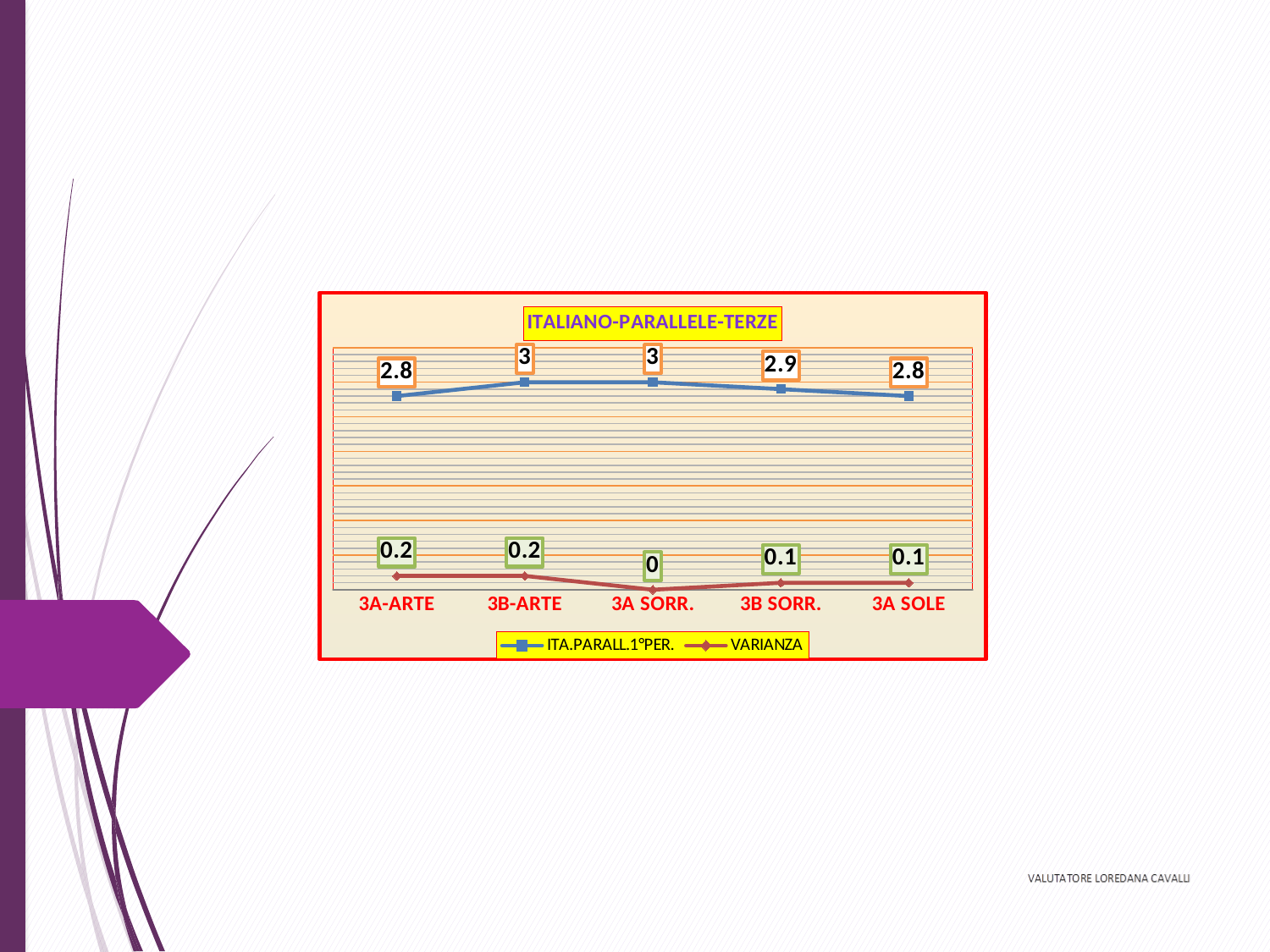
What is the ITA.PARALL.1°PER. value for 3A-ARTE? 2.8 What type of chart is shown on the slide? line chart Which is larger, the ITA.PARALL.1°PER. value for 3A SORR. or for 3B SORR.? 3A SORR. What is the title of the chart? ITALIANO-PARALLELE-TERZE What is the difference between the ITA.PARALL.1°PER. values for 3B-ARTE and 3A SOLE? 0.2 What is the VARIANZA value for 3B-ARTE? 0.2 What is the ITA.PARALL.1°PER. value for 3B SORR.? 2.9 How many series does the legend list? 2 What is the VARIANZA value for 3A SORR.? 0 Which category has the lowest VARIANZA value? 3A SORR. How many categories are shown on the x axis? 5 Which series is drawn in blue? ITA.PARALL.1°PER.